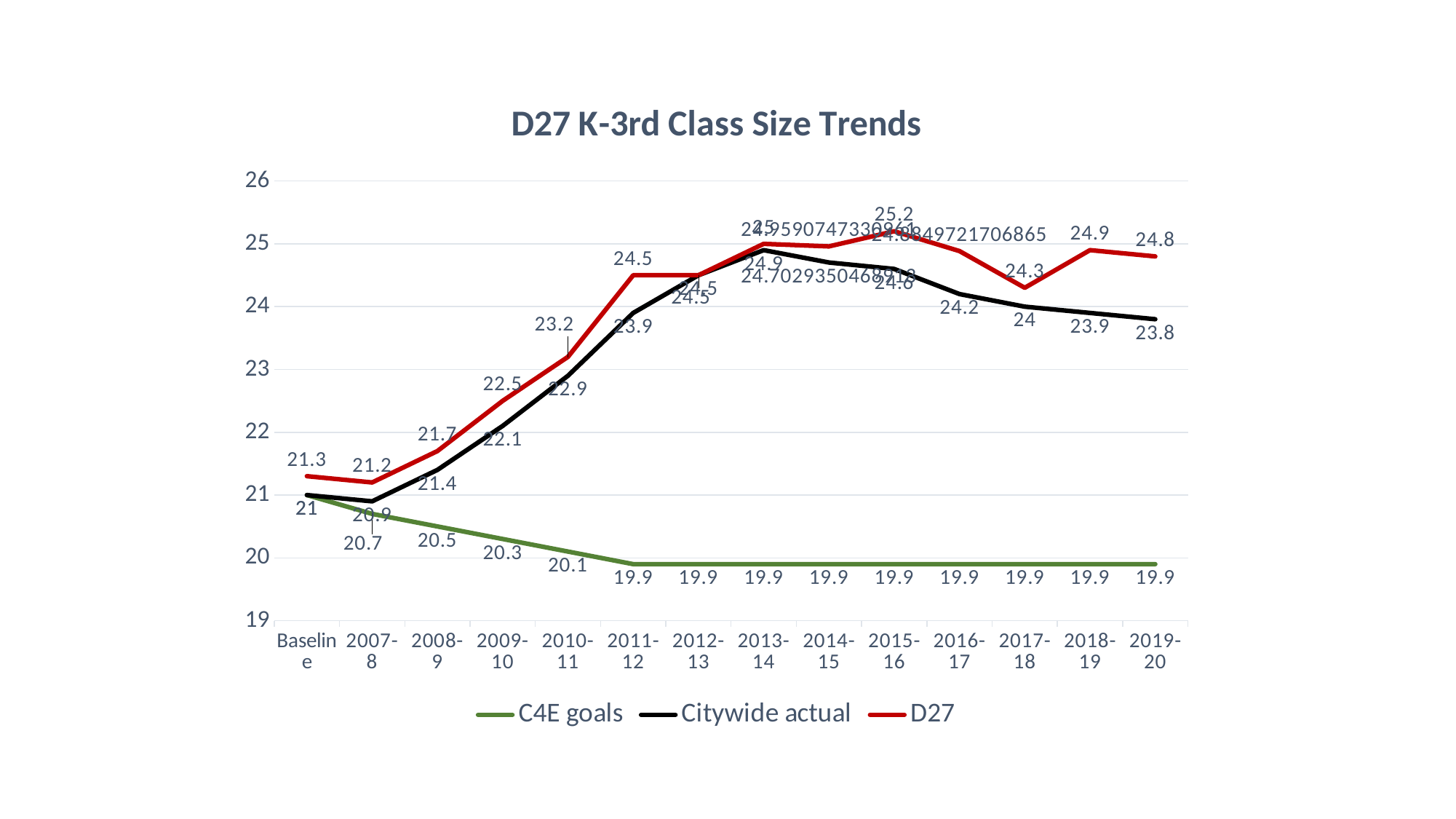
What type of chart is shown on the slide? line chart In which year does the Citywide actual series reach its lowest value? 2007-8 What is the D27 value for 2019-20? 24.8 Is the Citywide actual value for 2013-14 greater or less than 24? greater What is the difference between the D27 values for 2018-19 and 2017-18? 0.6 What is the difference between the D27 and Citywide actual values in 2019-20? 1 Which is larger in 2017-18, the D27 value or the Citywide actual value? D27 What is the Citywide actual value for 2019-20? 23.8 How many categories are shown along the x axis? 14 Do the C4E goals values rise or fall from Baseline to 2011-12? fall What is the C4E goals value for 2010-11? 20.1 How many series does the legend list? 3